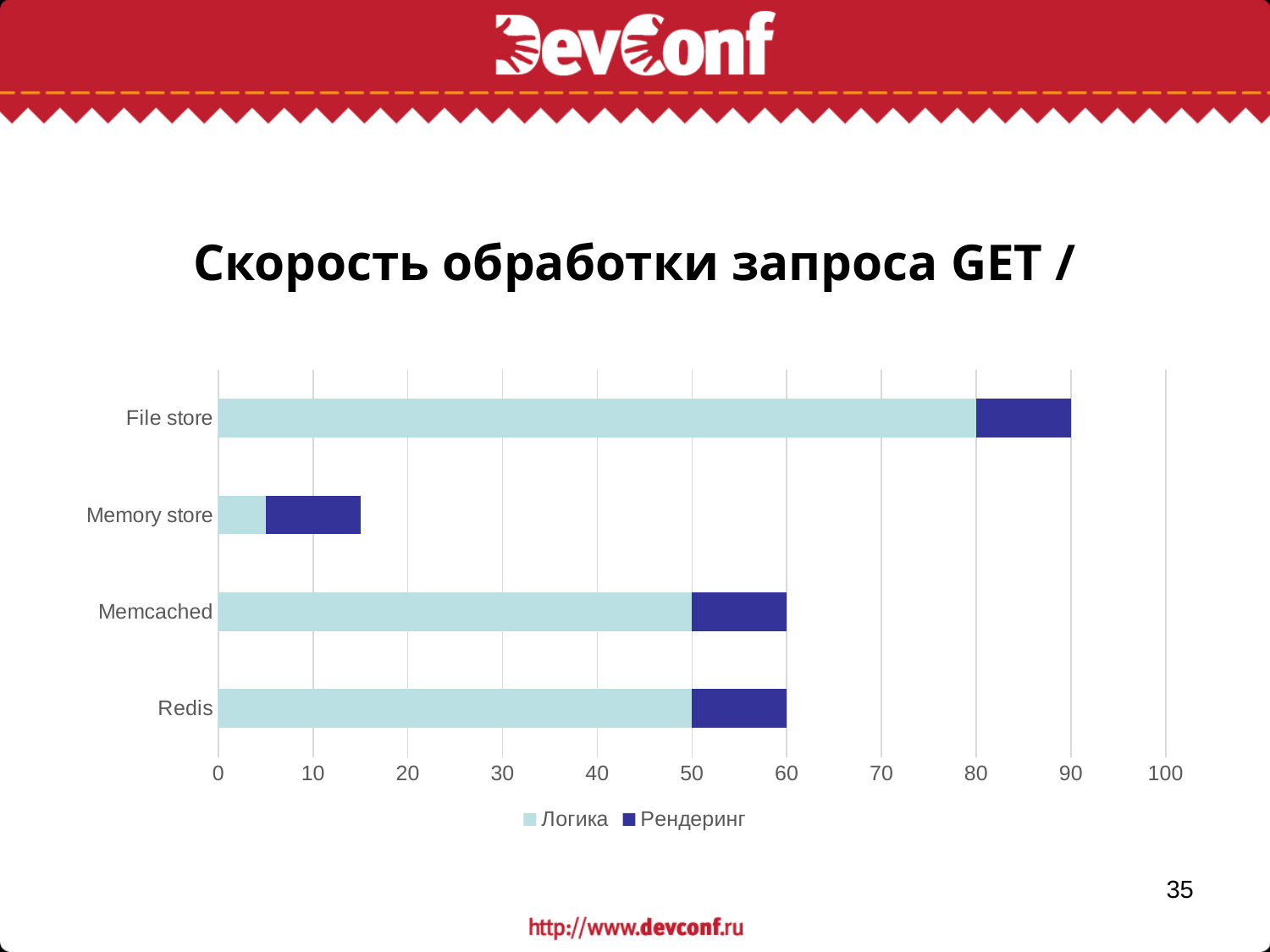
What is the Логика value for Redis? 50 Which category has the longest total bar? File store What is the total of the stacked bar for Memcached? 60 What is the total of the stacked bar for File store? 90 How many series does the legend list? 2 How many categories are shown on the chart? 4 Which has a larger total bar, File store or Memory store? File store What is the Логика value for File store? 80 What are the two series named in the legend? Логика, Рендеринг What kind of chart is shown on the slide? bar chart Is the total value for Memory store greater or less than 20? less Which category has the shortest total bar? Memory store